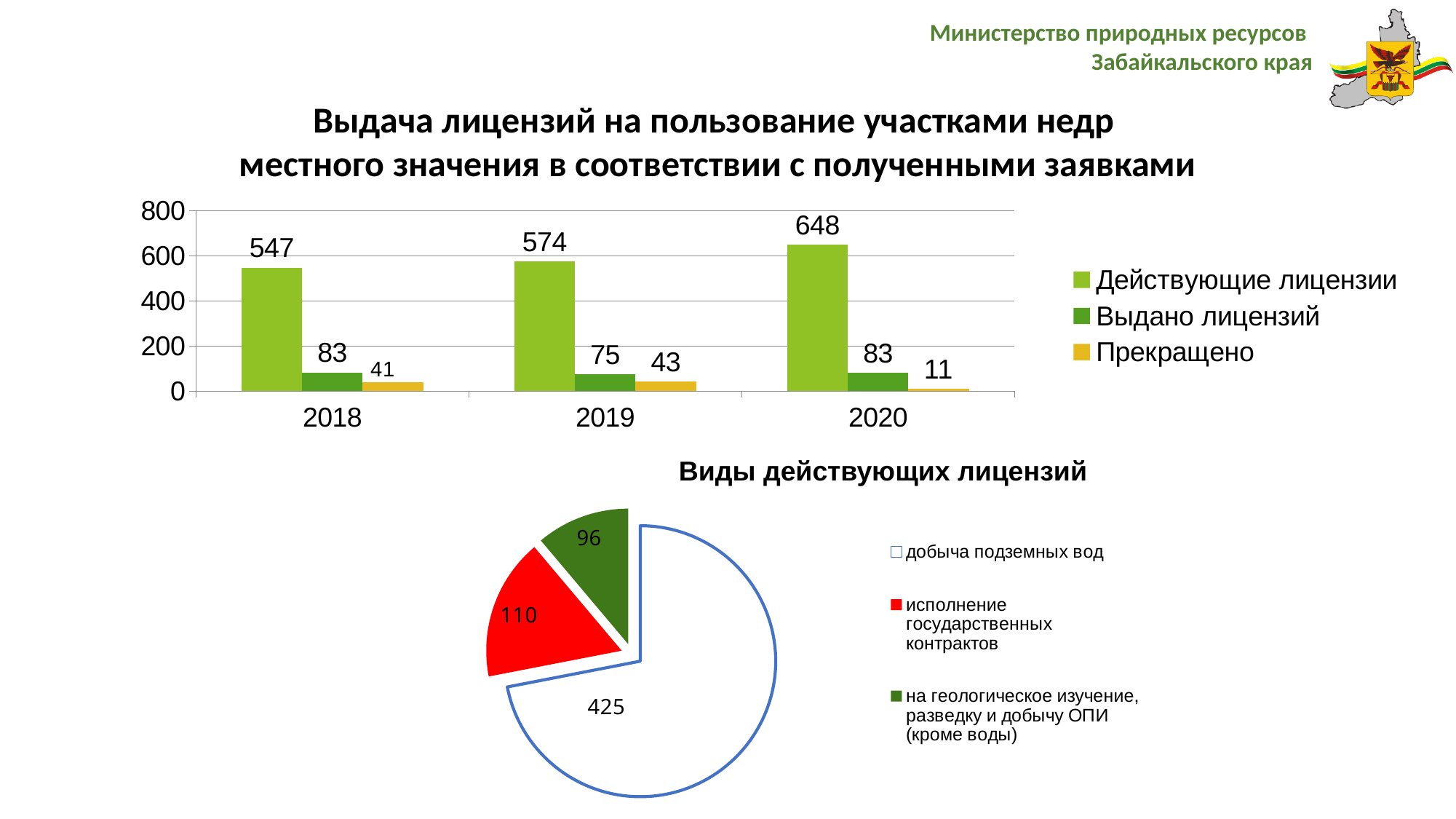
In the bar chart at the top of the slide, what is the value of Действующие лицензии for 2020? 648 In the bar chart at the top of the slide, what is the difference between Действующие лицензии in 2020 and in 2018? 101 What kind of chart is the chart titled Виды действующих лицензий? pie chart In the bar chart at the top of the slide, which year has the highest value for Действующие лицензии? 2020 In the bar chart at the top of the slide, is the value of Прекращено for 2019 larger or smaller than the value for 2020? larger In the bar chart at the top of the slide, what is the value of Выдано лицензий for 2019? 75 In the pie chart titled Виды действующих лицензий, which category has the largest slice? добыча подземных вод In the bar chart at the top of the slide, how many series does the legend list? 3 In the pie chart titled Виды действующих лицензий, what is the value for исполнение государственных контрактов? 110 In the bar chart at the top of the slide, do the values for Действующие лицензии rise or fall from 2018 to 2020? rise In the bar chart at the top of the slide, what is the value of Прекращено for 2018? 41 In the bar chart at the top of the slide, which year has the lowest value for Прекращено? 2020